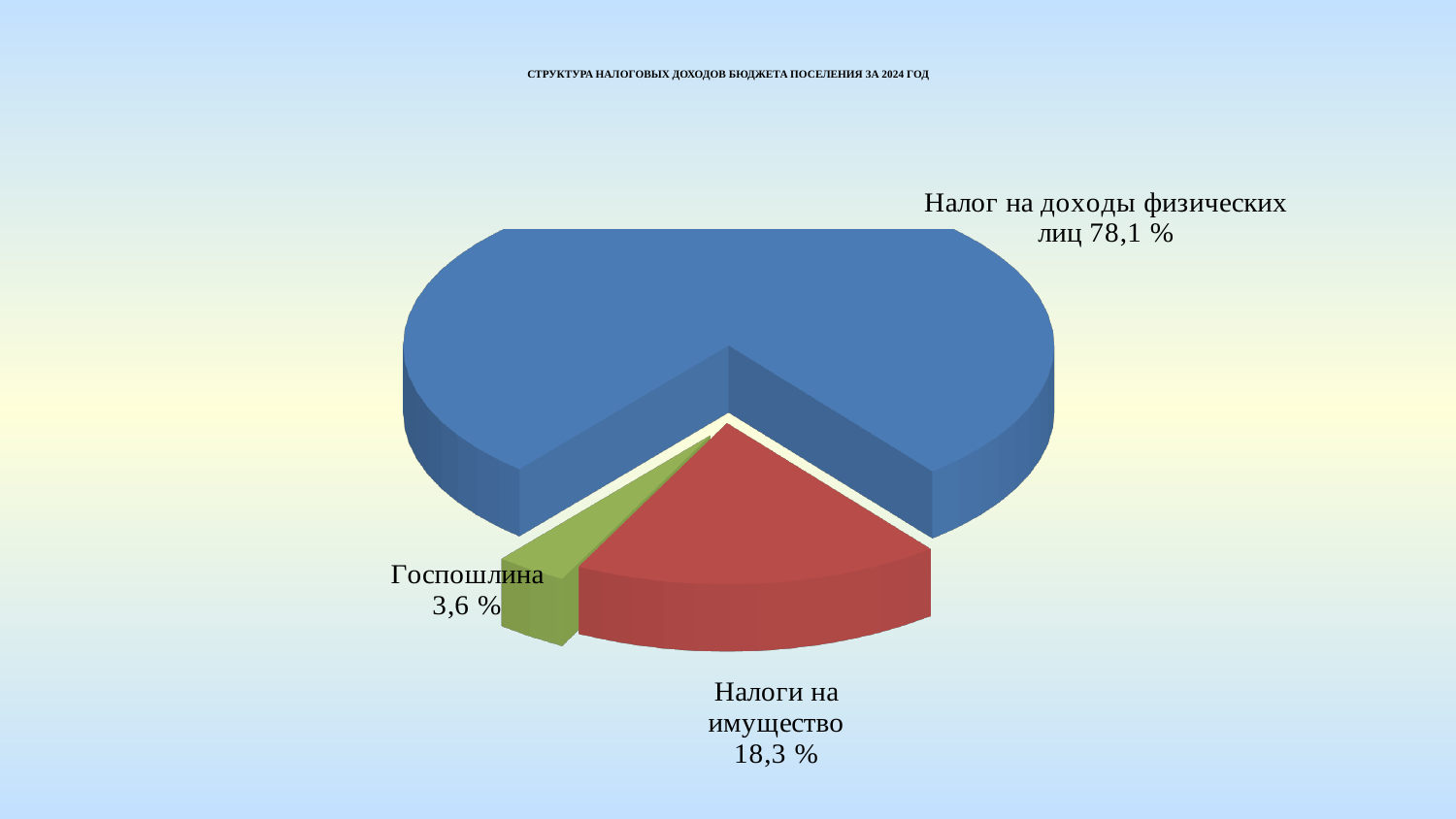
What colour is the slice for "Налоги на имущество"? Red What type of chart is shown on the slide? Pie chart How many slices does the pie chart have? 3 What is the title of the chart? СТРУКТУРА НАЛОГОВЫХ ДОХОДОВ БЮДЖЕТА ПОСЕЛЕНИЯ ЗА 2024 ГОД What share of tax revenues does "Налоги на имущество" account for? 18,3 % What share of tax revenues does "Налог на доходы физических лиц" account for? 78,1 % What is the difference in percentage points between "Налоги на имущество" and "Госпошлина"? 14,7 What is the difference in percentage points between "Налог на доходы физических лиц" and "Налоги на имущество"? 59,8 Which category has the largest share of the pie? Налог на доходы физических лиц Which is larger: the share of "Налоги на имущество" or the share of "Госпошлина"? Налоги на имущество Which category has the smallest share of the pie? Госпошлина What share of tax revenues does "Госпошлина" account for? 3,6 %